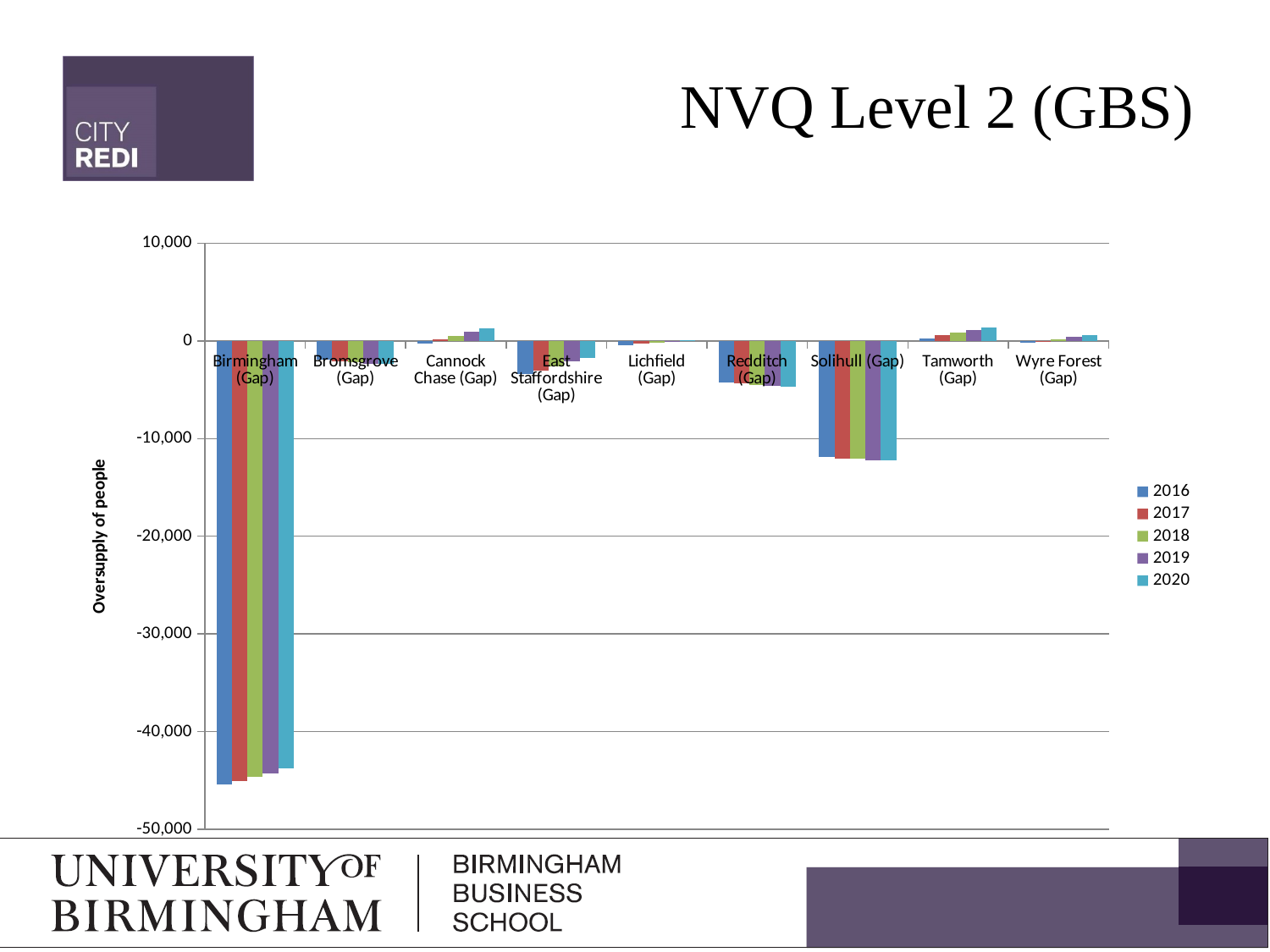
Is the 2018 value for Redditch (Gap) greater or less than -10,000? greater Which has the larger (less negative) 2017 value, Solihull (Gap) or Redditch (Gap)? Redditch (Gap) Which category has the lowest (most negative) values in the chart? Birmingham (Gap) What is the title of the chart? NVQ Level 2 (GBS) What kind of chart is shown on the slide? Bar chart Do the values for Tamworth (Gap) rise or fall from 2016 to 2020? rise How many categories (areas) are shown on the x axis of the chart? 9 Is the 2016 value for Birmingham (Gap) greater or less than -40,000? less Is the 2020 value for Solihull (Gap) greater or less than -10,000? less How many series does the legend list? 5 Which has the lower (more negative) 2019 value, Birmingham (Gap) or Solihull (Gap)? Birmingham (Gap) What is the label on the vertical axis of the chart? Oversupply of people